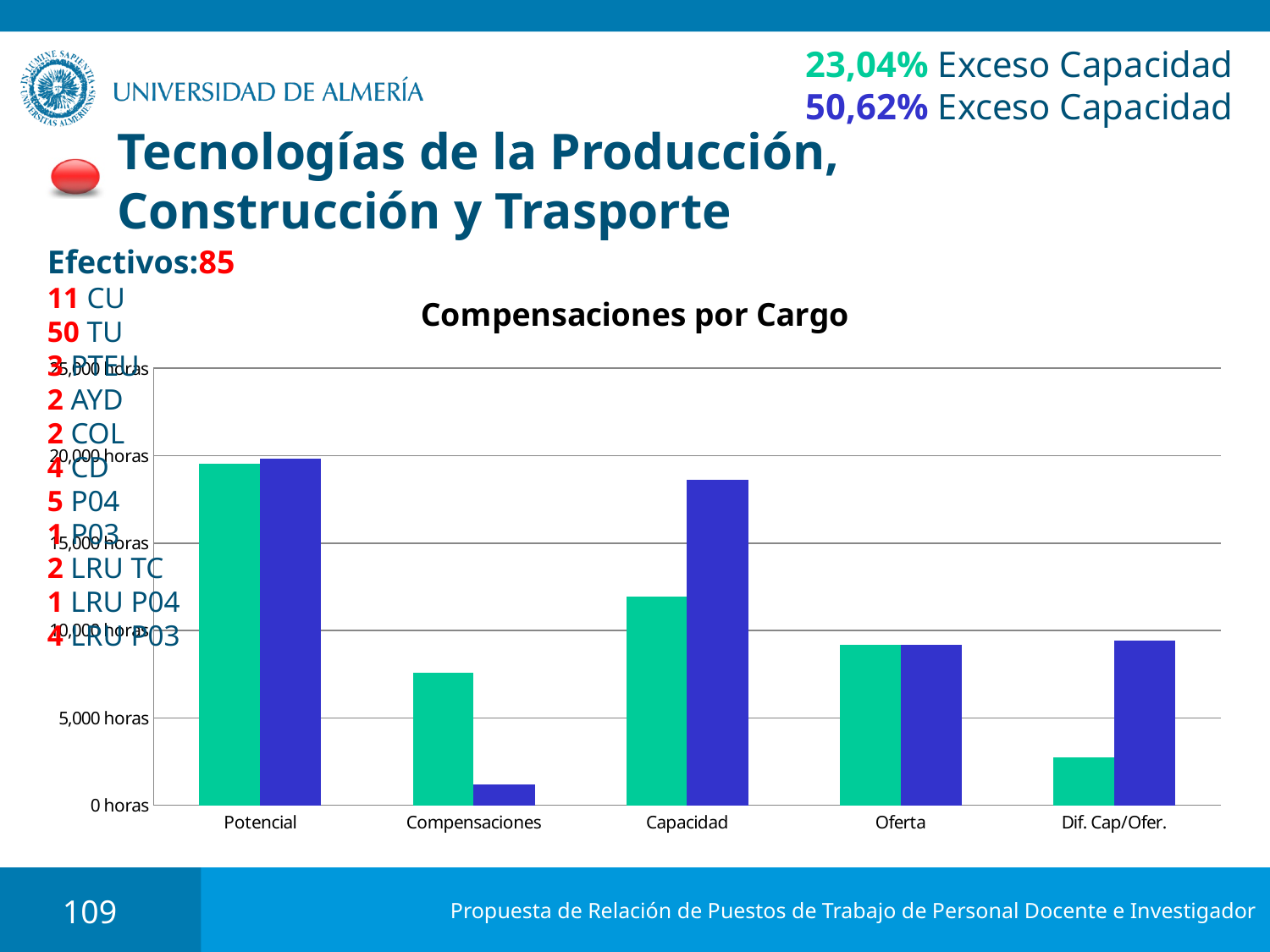
For Capacidad, which bar is larger, the green one or the blue one? the blue one Which category has the tallest green bar? Potencial Is the green bar for Potencial greater or less than 15,000 horas? greater Is the blue bar for Capacidad greater or less than 15,000 horas? greater Is the green bar for Compensaciones greater or less than 10,000 horas? less For Compensaciones, which bar is larger, the green one or the blue one? the green one Which category has the shortest blue bar? Compensaciones How many categories are shown on the x axis of the chart? 5 What is the title of the chart? Compensaciones por Cargo What kind of chart is shown on the slide? bar chart